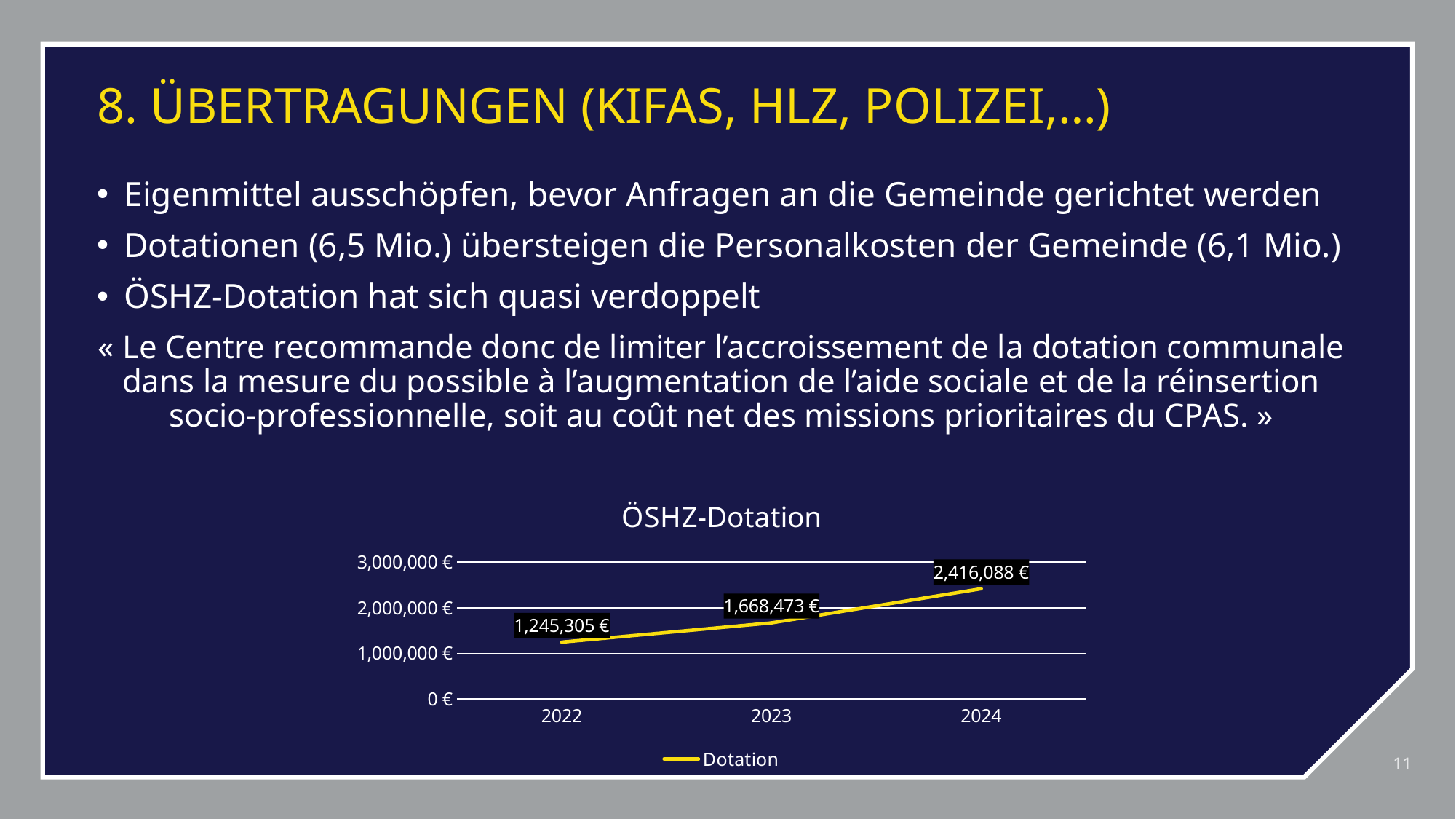
What is the value of the Dotation for 2024? 2,416,088 € What is the difference between the Dotation values for 2023 and 2022? 423,168 € What is the value of the Dotation for 2023? 1,668,473 € Which year has the highest Dotation value? 2024 What kind of chart is shown on the slide? line chart What is the value of the Dotation for 2022? 1,245,305 € Which year has the lowest Dotation value? 2022 What is the difference between the Dotation values for 2024 and 2022? 1,170,783 € How many years are plotted on the chart? 3 Which year has the larger Dotation value, 2023 or 2024? 2024 Is the Dotation value for 2024 greater or less than 2,000,000 €? greater Does the Dotation value rise or fall from 2022 to 2024? rise